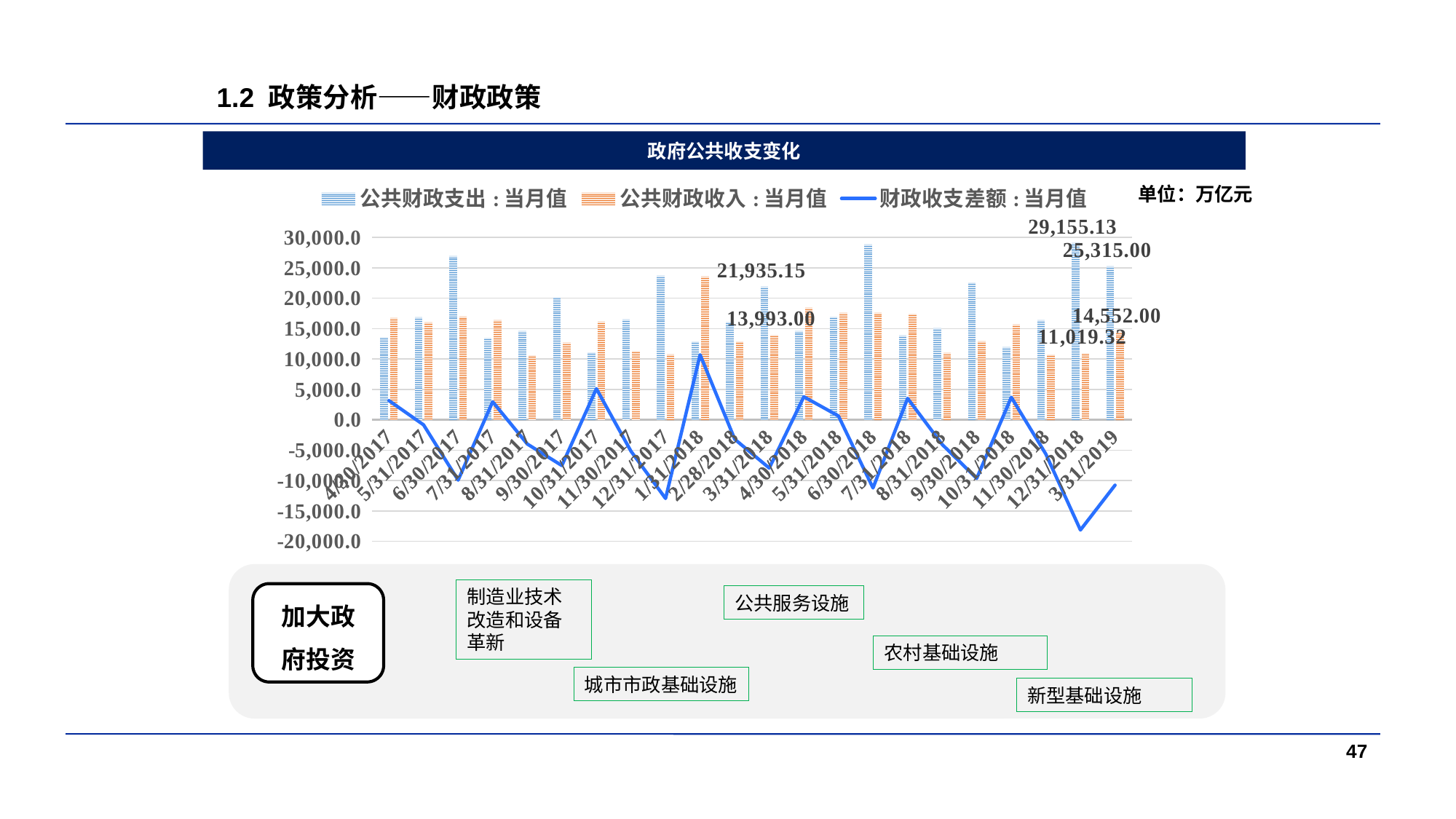
What is the value of 公共财政支出:当月值 for 3/31/2019? 25,315.00 What kind of chart is shown on the slide? A combined bar and line chart Is the value of 公共财政支出:当月值 for 6/30/2017 greater or less than 25,000? greater What is the value of 公共财政支出:当月值 for 12/31/2018? 29,155.13 What unit is stated for the values in the chart? 万亿元 What is the value of 公共财政收入:当月值 for 3/31/2019? 14,552.00 How many series does the legend of the chart list? 3 On which date is the 公共财政支出:当月值 bar the highest? 12/31/2018 What is the difference between 公共财政支出:当月值 and 公共财政收入:当月值 for 12/31/2018? 18,135.81 What is the value of 公共财政收入:当月值 for 12/31/2018? 11,019.32 How many dates are shown along the x axis of the chart? 22 For 3/31/2019, which is larger: 公共财政支出:当月值 or 公共财政收入:当月值? 公共财政支出:当月值